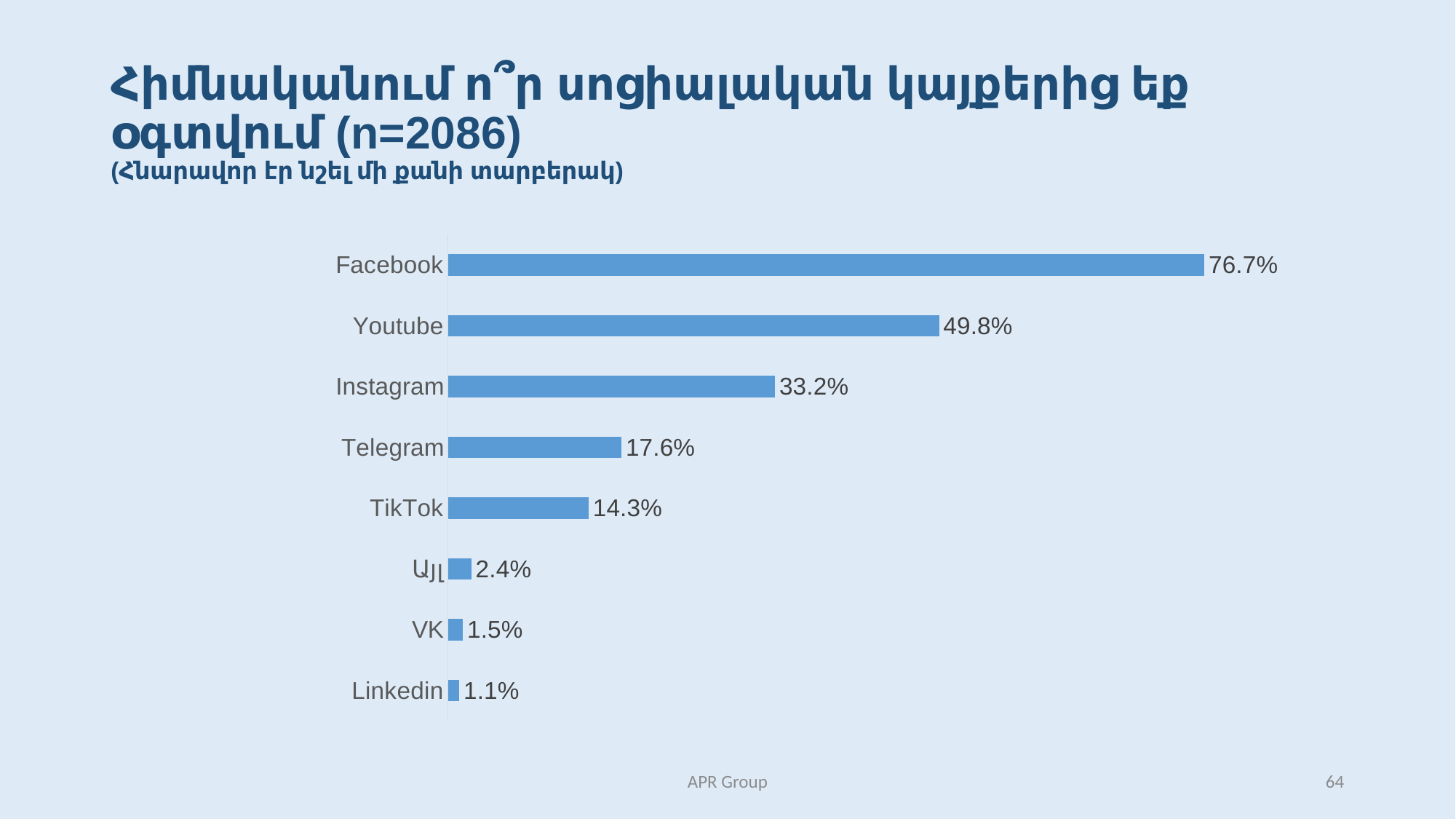
Which category has the highest value? Facebook What colour are the bars in the chart? Blue Which category has the lowest value? Linkedin What is the difference between the values for Telegram and TikTok? 3.3% What is the difference between the values for Facebook and Youtube? 26.9% What kind of chart is shown on the slide? Bar chart What is the value for TikTok? 14.3% What is the value for VK? 1.5% What is the value for Facebook? 76.7% How many categories are shown in the chart? 8 What is the value for Instagram? 33.2% Which is larger, the value for Youtube or the value for Instagram? Youtube